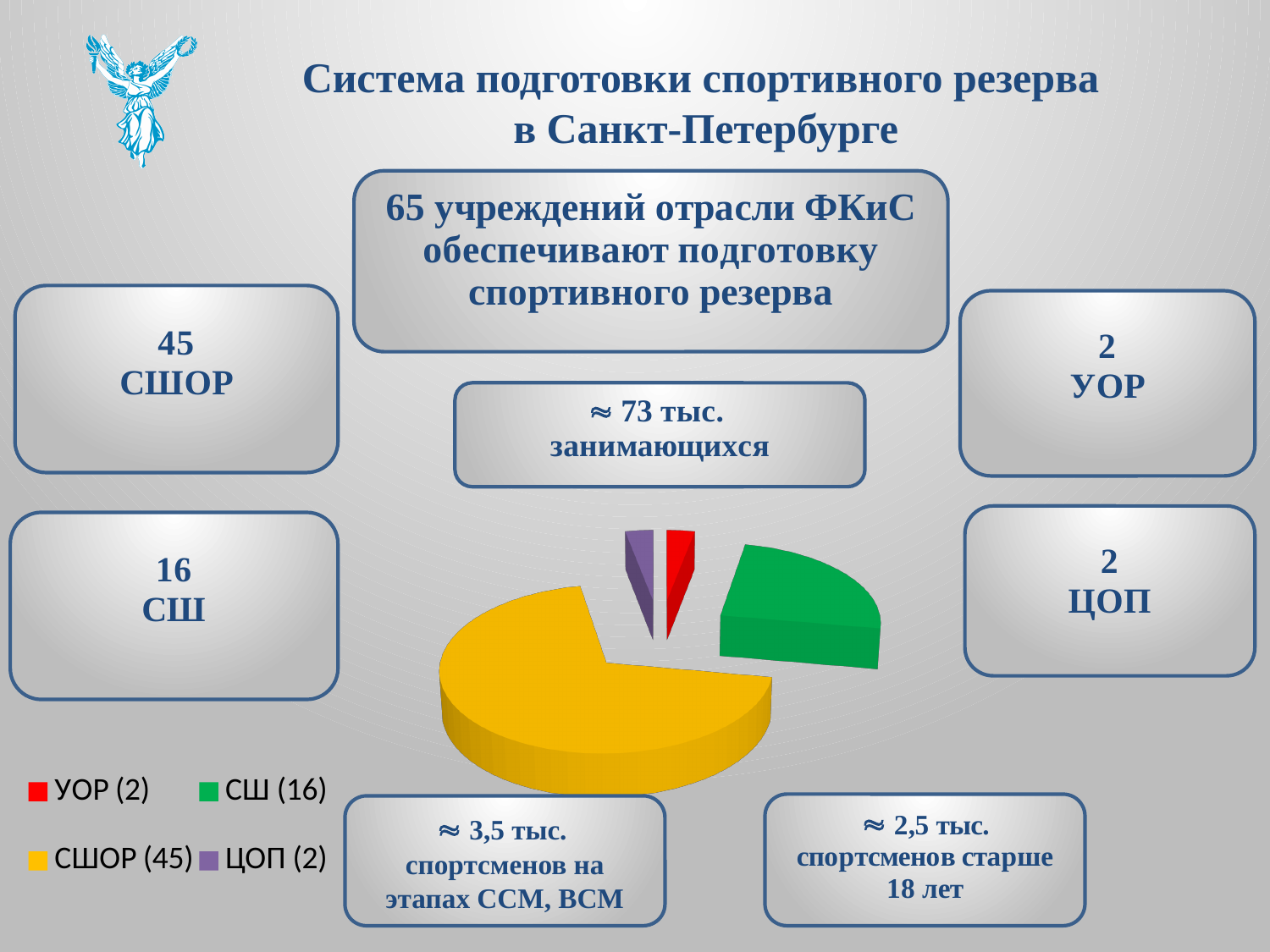
What is the value for ЦОП in the pie chart? 2 Which is larger in the pie chart, СШ or СШОР? СШОР How many entries does the legend of the pie chart list? 4 What is the total of all the slices in the pie chart? 65 What colour is the СШОР slice in the pie chart? yellow What is the value for УОР in the pie chart? 2 Which category has the largest slice in the pie chart? СШОР What is the value for СШОР in the pie chart? 45 What is the value for СШ in the pie chart? 16 What kind of chart is shown on the slide? pie chart What is the difference between the values for СШОР and СШ in the pie chart? 29 How many slices does the pie chart have? 4